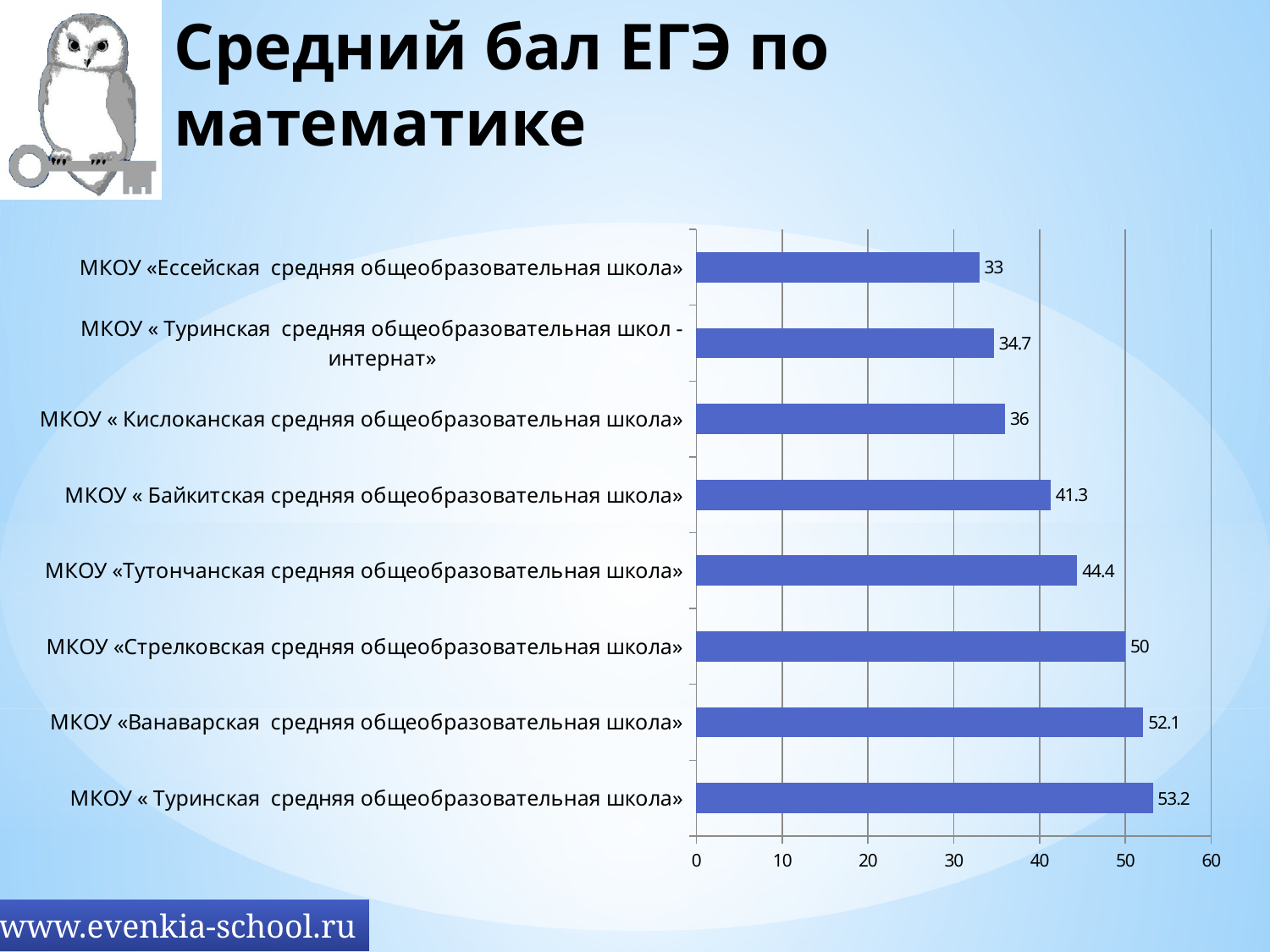
Which school has the highest average math exam score? МКОУ « Туринская средняя общеобразовательная школа» What type of chart is shown on the slide? bar chart What is the average math exam score for МКОУ «Ессейская средняя общеобразовательная школа»? 33 What is the value shown for МКОУ «Ванаварская средняя общеобразовательная школа»? 52.1 What is the value shown for МКОУ « Байкитская средняя общеобразовательная школа»? 41.3 What is the difference between the scores of МКОУ « Туринская средняя общеобразовательная школа» and МКОУ «Ессейская средняя общеобразовательная школа»? 20.2 Which school has the lowest average math exam score? МКОУ «Ессейская средняя общеобразовательная школа» How many schools are shown in the chart? 8 What is the difference between the scores of МКОУ «Стрелковская средняя общеобразовательная школа» and МКОУ «Тутончанская средняя общеобразовательная школа»? 5.6 What is the title of the slide? Средний бал ЕГЭ по математике Which has a higher score: МКОУ « Кислоканская средняя общеобразовательная школа» or МКОУ « Туринская средняя общеобразовательная школ - интернат»? МКОУ « Кислоканская средняя общеобразовательная школа» Is the value for МКОУ «Тутончанская средняя общеобразовательная школа» greater or less than 40? greater